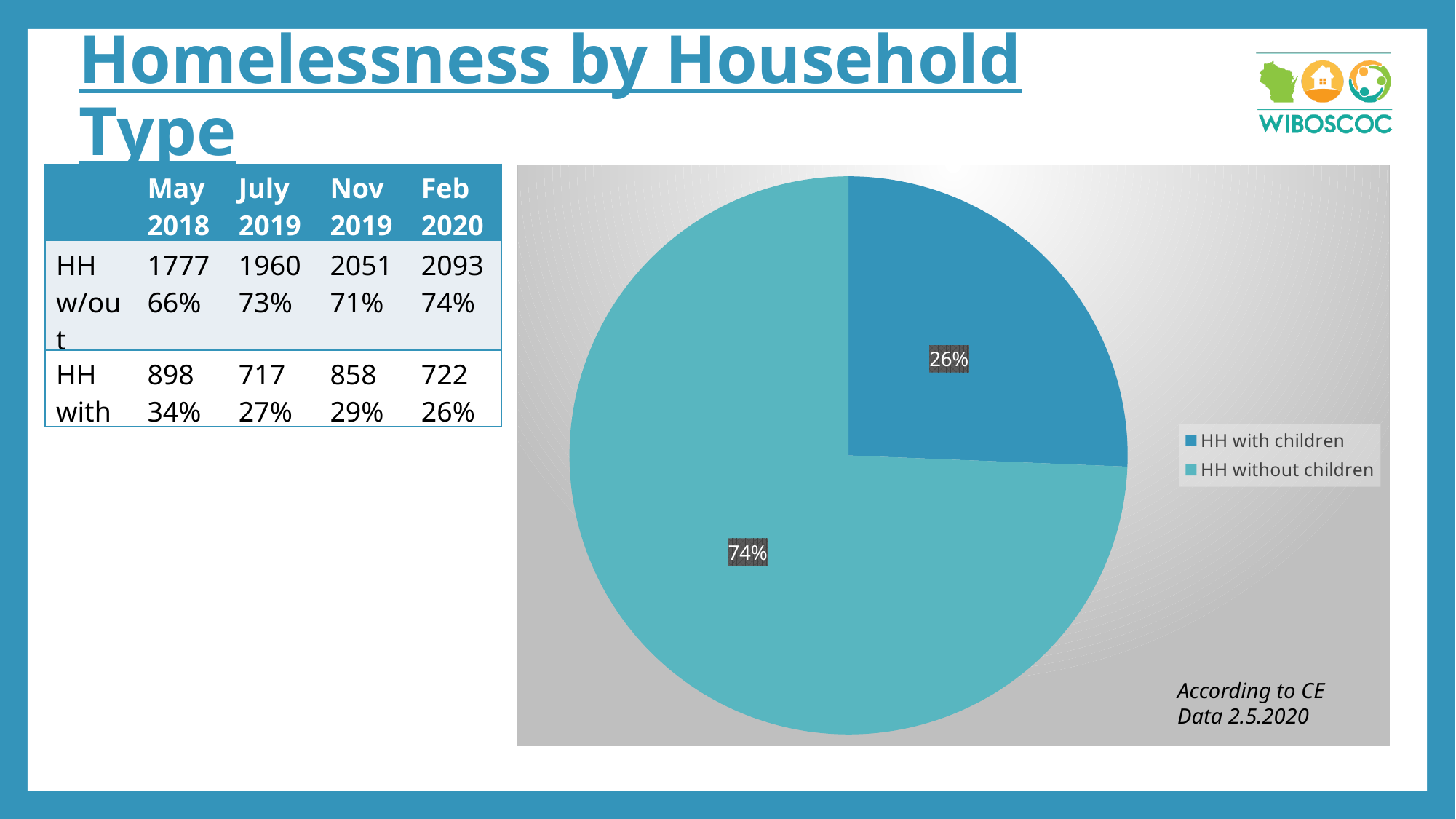
What is the difference in percentage points between the HH without children slice and the HH with children slice? 48 What share of the pie chart is labelled for HH without children? 74% Which is larger in the pie chart: HH with children or HH without children? HH without children Which legend entry is shown in the darker blue colour? HH with children How many entries does the pie chart's legend list? 2 What kind of chart is shown on the slide? pie chart Which slice of the pie chart is the largest? HH without children What data source note is printed in the bottom right of the chart area? According to CE Data 2.5.2020 What share of the pie chart is labelled for HH with children? 26% How many slices does the pie chart have? 2 Which slice of the pie chart is the smallest? HH with children